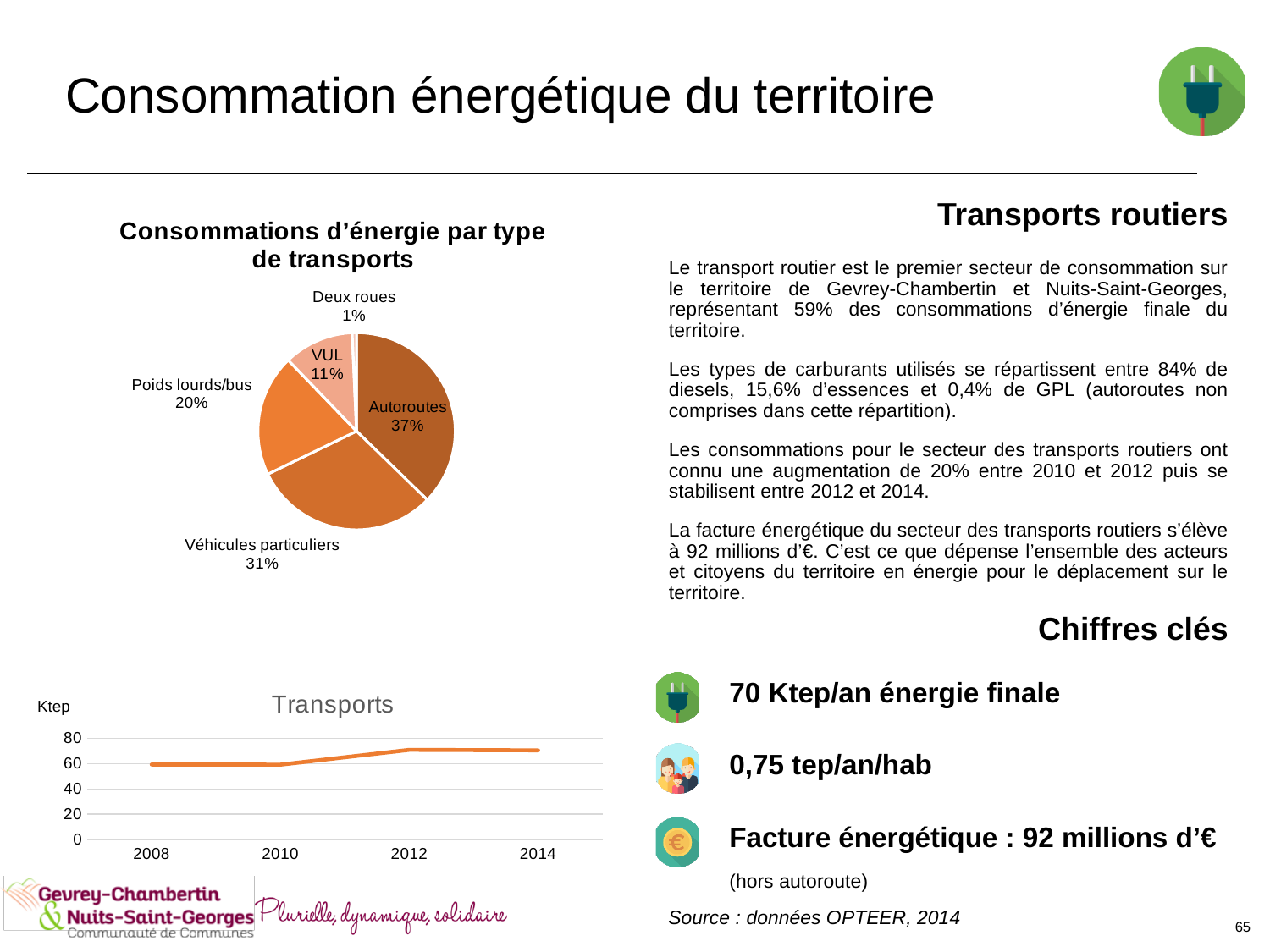
What unit is shown on the vertical axis of the 'Transports' line chart? Ktep In the 'Transports' line chart, is the value for 2014 greater or less than 60? greater In the 'Transports' line chart, do the values rise or fall from 2008 to 2014? Rise How many categories does the pie chart 'Consommations d'énergie par type de transports' show? 5 In the pie chart 'Consommations d'énergie par type de transports', which is larger: Poids lourds/bus or VUL? Poids lourds/bus In the pie chart 'Consommations d'énergie par type de transports', which category has the smallest share? Deux roues What type of chart is the 'Transports' chart at the bottom left of the slide? Line chart In the pie chart 'Consommations d'énergie par type de transports', what share does VUL have? 11% In the pie chart 'Consommations d'énergie par type de transports', what is the difference between the shares of Autoroutes and Véhicules particuliers? 6% In the pie chart 'Consommations d'énergie par type de transports', which category has the largest share? Autoroutes In the pie chart 'Consommations d'énergie par type de transports', what share does Poids lourds/bus have? 20% In the pie chart 'Consommations d'énergie par type de transports', what share does Autoroutes have? 37%